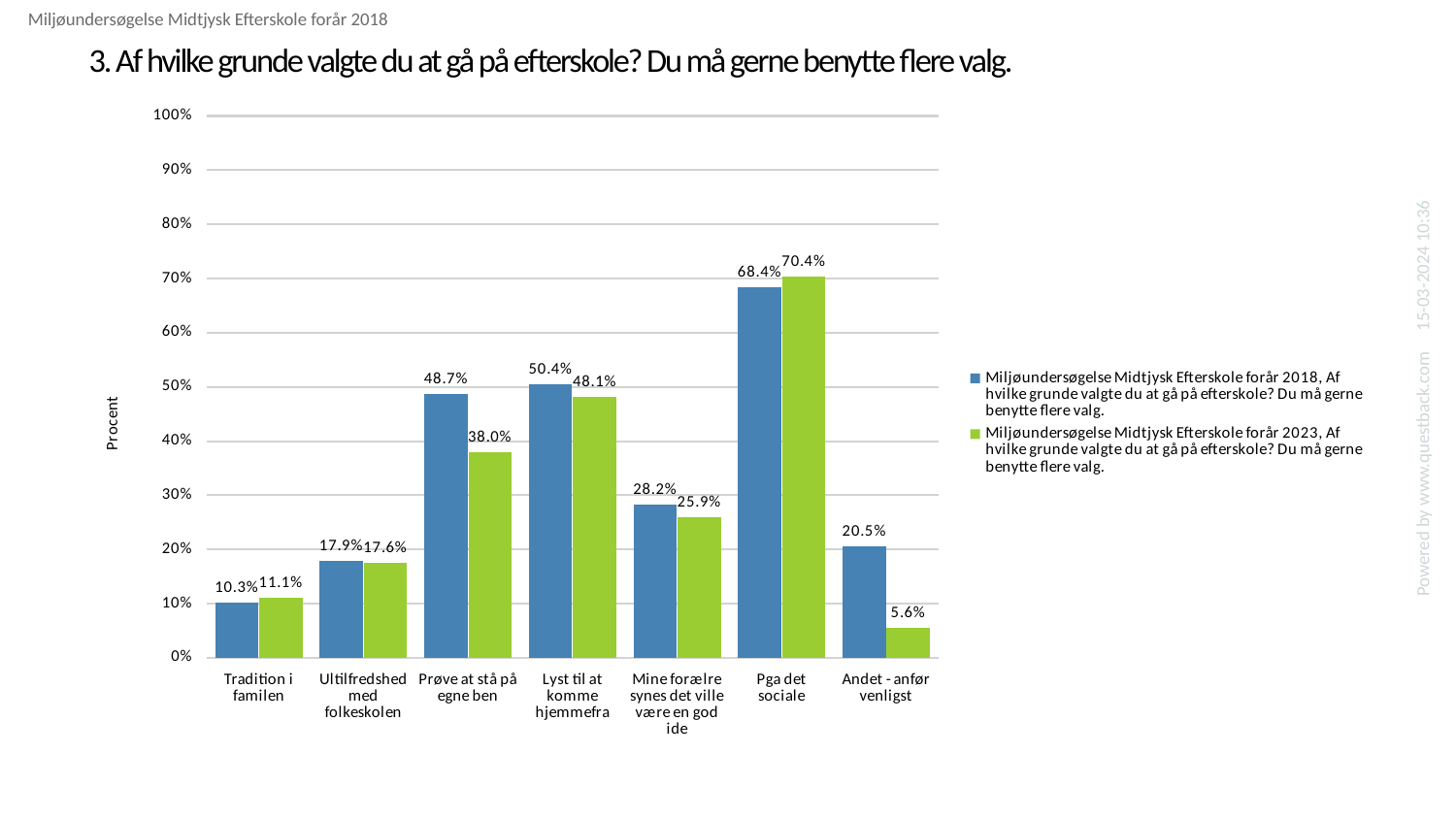
What is the difference between the 2018 and 2023 values for "Andet - anfør venligst"? 14.9% How many series does the legend list? 2 What is the 2018 value for "Pga det sociale"? 68.4% What is the 2023 value for "Andet - anfør venligst"? 5.6% What is the 2023 value for "Prøve at stå på egne ben"? 38.0% Which category has the lowest value in the 2018 series? Tradition i familen What kind of chart is shown on the slide? Bar chart Is the 2018 value for "Lyst til at komme hjemmefra" greater or less than 50%? greater Which category has the highest value in the 2023 series? Pga det sociale Which is larger for "Pga det sociale": the 2018 value or the 2023 value? 2023 How many categories are shown on the x axis? 7 What is the difference between the 2018 and 2023 values for "Prøve at stå på egne ben"? 10.7%